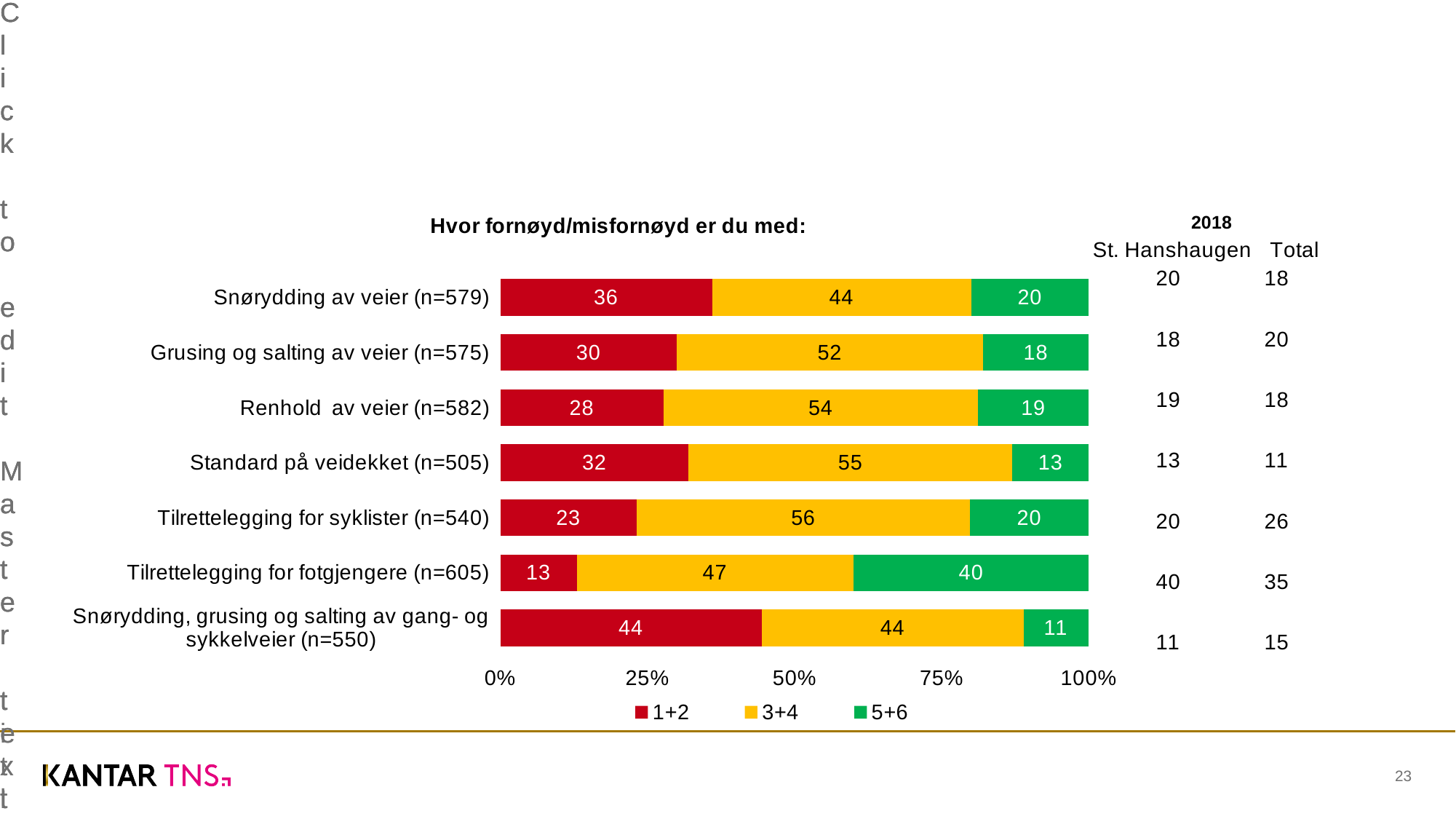
What is the value of the 1+2 series for Snørydding av veier (n=579)? 36 What is the value of the 3+4 series for Tilrettelegging for syklister (n=540)? 56 Which category has the highest value for the 5+6 series? Tilrettelegging for fotgjengere (n=605) Which has the larger 1+2 value: Standard på veidekket (n=505) or Renhold av veier (n=582)? Standard på veidekket (n=505) What is the value of the 5+6 series for Standard på veidekket (n=505)? 13 What kind of chart is shown on the slide? Stacked bar chart Which category has the lowest value for the 1+2 series? Tilrettelegging for fotgjengere (n=605) What is the difference between the 5+6 values for Tilrettelegging for fotgjengere (n=605) and Snørydding, grusing og salting av gang- og sykkelveier (n=550)? 29 What is the total of the stacked bar for Grusing og salting av veier (n=575)? 100 What is the title of the chart? Hvor fornøyd/misfornøyd er du med: How many categories are shown in the chart? 7 How many series does the legend list? 3